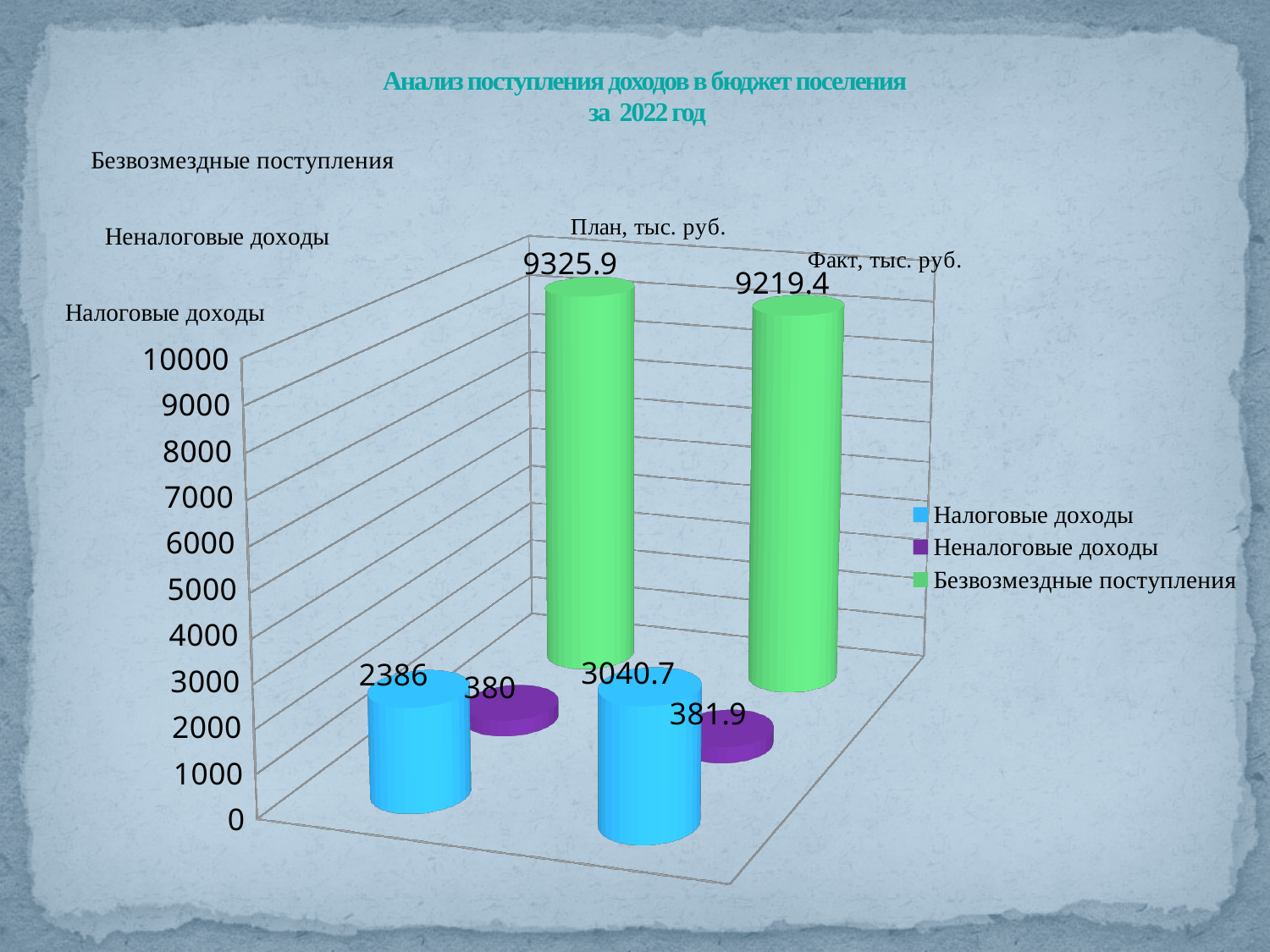
What colour represents Неналоговые доходы in the chart? Purple What is the difference between the planned and actual values for Налоговые доходы? 654.7 What is the actual value (Факт, тыс. руб.) for Неналоговые доходы? 381.9 Which series has the lowest value in the Факт, тыс. руб. category? Неналоговые доходы How many series does the legend list? 3 What is the planned value (План, тыс. руб.) for Налоговые доходы? 2386 How many categories are shown on the x axis? 2 What is the actual value (Факт, тыс. руб.) for Налоговые доходы? 3040.7 Which is larger for Безвозмездные поступления: the План value or the Факт value? План What is the planned value (План, тыс. руб.) for Безвозмездные поступления? 9325.9 What kind of chart is shown on the slide? Bar chart Which series has the highest value in the План, тыс. руб. category? Безвозмездные поступления